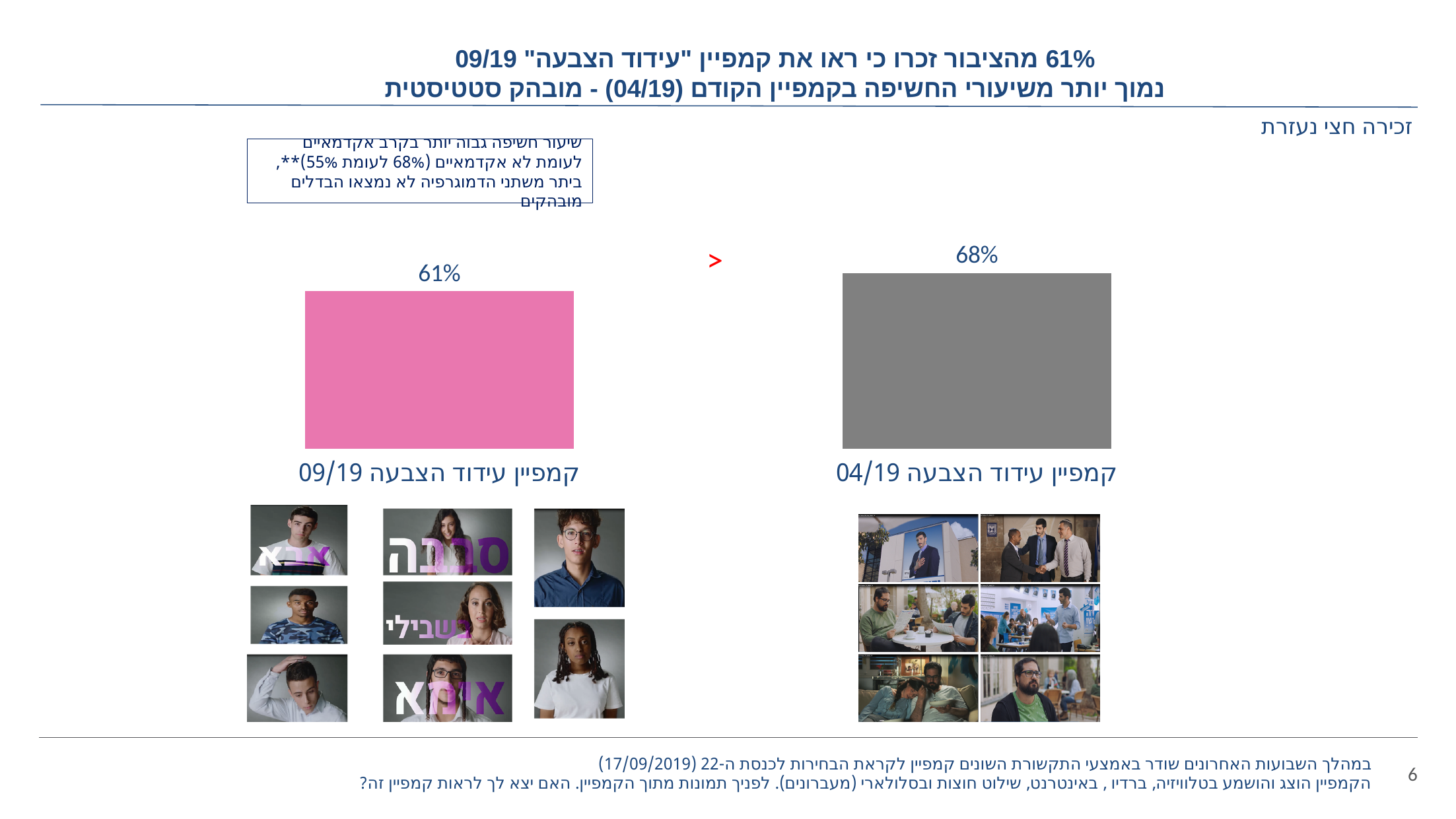
Is the value for the 09/19 campaign larger or smaller than the value for the 04/19 campaign? smaller What colour is the bar for the 04/19 campaign? gray Is the value for the 04/19 campaign greater or less than 65%? greater Which campaign has the higher exposure rate, 09/19 or 04/19? 04/19 What value is shown for the 09/19 voter-encouragement campaign (קמפיין עידוד הצבעה 09/19)? 61% What value is shown for the 04/19 voter-encouragement campaign (קמפיין עידוד הצבעה 04/19)? 68% Is the value for the 09/19 campaign greater or less than 65%? less What is the difference between the 04/19 campaign value and the 09/19 campaign value? 7% How many bars are plotted on the slide? 2 What colour is the bar for the 09/19 campaign? pink Which campaign has the lower exposure rate, 09/19 or 04/19? 09/19 What kind of chart is shown on the slide? bar chart